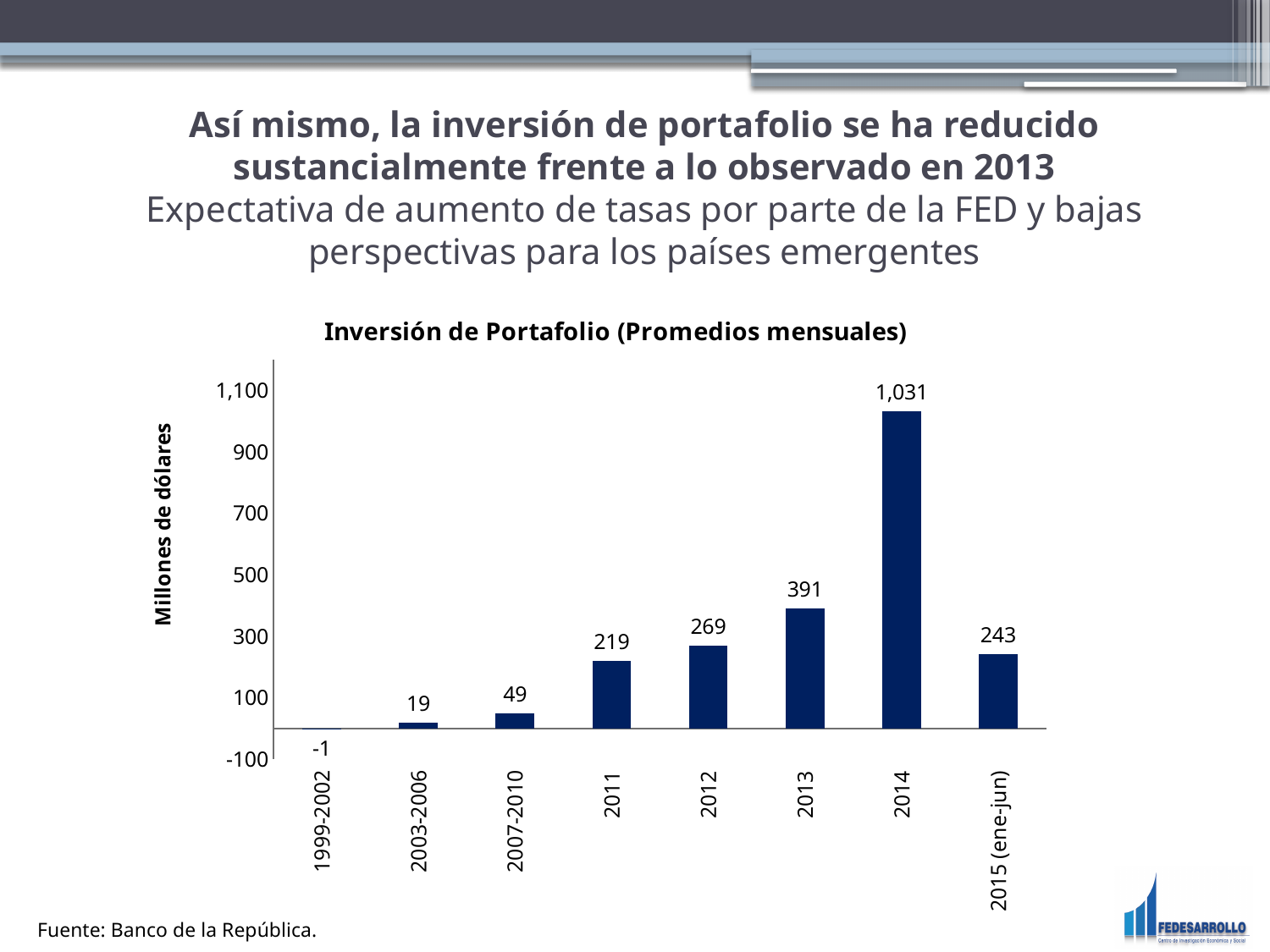
What kind of chart is shown on the slide? Bar chart How many categories are shown on the x axis? 8 What is the value for 1999-2002? -1 Do the values rise or fall from 1999-2002 through 2014? Rise What is the value for 2014 in the chart? 1,031 What is the value for 2015 (ene-jun)? 243 What is the difference between the values for 2014 and 2013? 640 What is the difference between the values for 2012 and 2011? 50 Which category has the highest value? 2014 Which category has the lowest value? 1999-2002 Which is larger, the value for 2013 or the value for 2015 (ene-jun)? 2013 What is the label of the vertical axis? Millones de dólares